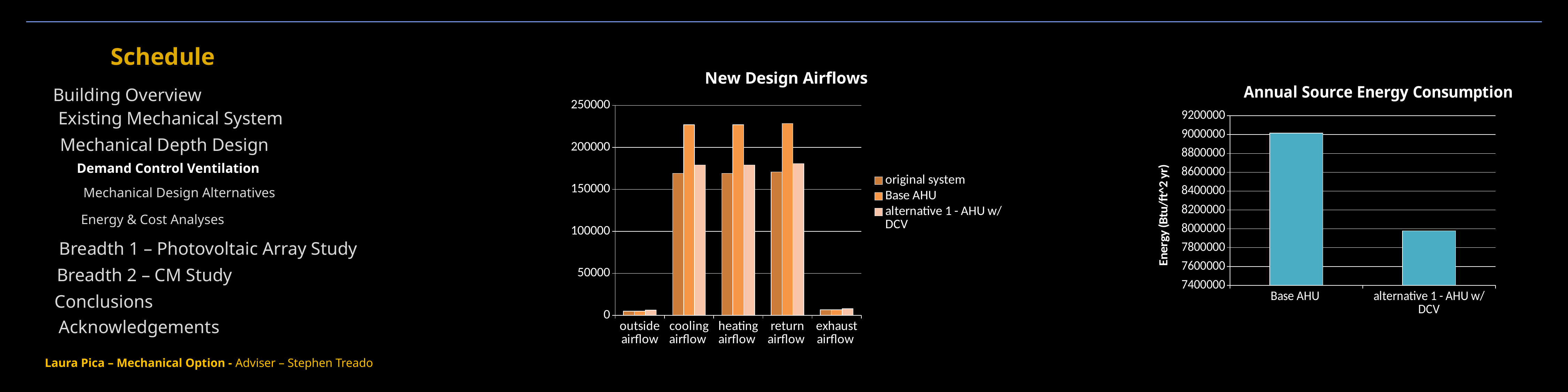
On the New Design Airflows chart, is the Base AHU value for cooling airflow greater or less than 200000? greater On the New Design Airflows chart, is the original system value for outside airflow greater or less than 50000? less On the New Design Airflows chart, which series has the larger value for cooling airflow: original system or Base AHU? Base AHU On the Annual Source Energy Consumption chart, is the value for alternative 1 - AHU w/ DCV greater or less than 8200000? less On the New Design Airflows chart, which series is shown in the lightest shade of orange? alternative 1 - AHU w/ DCV What is the y-axis label on the Annual Source Energy Consumption chart? Energy (Btu/ft^2 yr) What type of chart is the Annual Source Energy Consumption chart? bar chart On the New Design Airflows chart, how many airflow categories are shown on the x axis? 5 On the New Design Airflows chart, how many series does the legend list? 3 On the Annual Source Energy Consumption chart, which category has the highest energy consumption? Base AHU